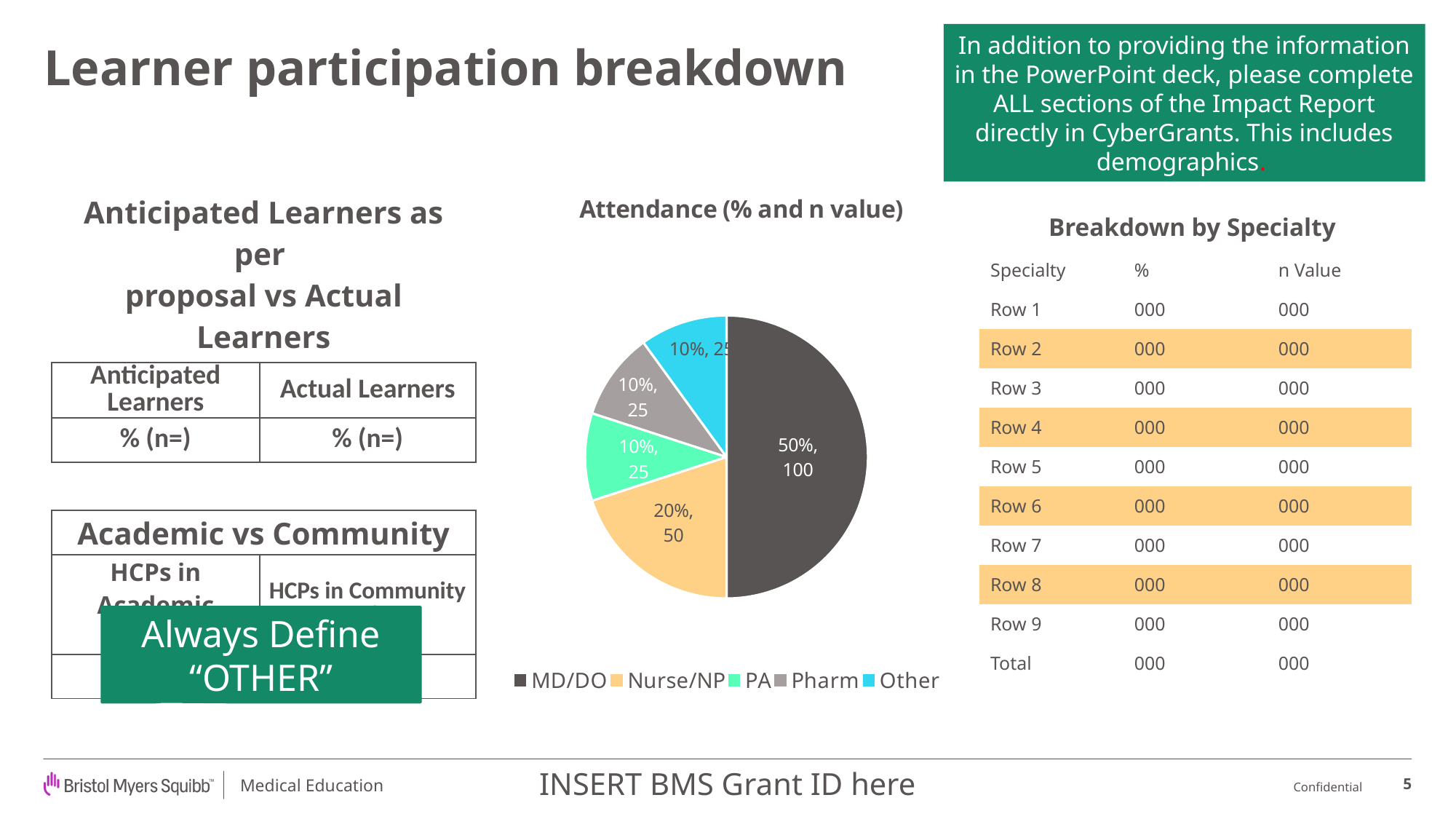
Which is larger in the pie chart, the Nurse/NP slice or the Pharm slice? Nurse/NP What percentage share of the pie chart does Nurse/NP have? 20% What is the n value shown for the Nurse/NP slice of the pie chart? 50 What is the title of the pie chart? Attendance (% and n value) What is the difference in n value between the MD/DO slice and the Nurse/NP slice in the pie chart? 50 What is the n value shown for the PA slice of the pie chart? 25 What kind of chart is shown under the title "Attendance (% and n value)"? pie chart What percentage share of the pie chart does MD/DO have? 50% How many series does the legend of the pie chart list? 5 What is the n value shown for the MD/DO slice of the pie chart? 100 How many slices does the pie chart have? 5 Which category has the largest slice in the pie chart? MD/DO